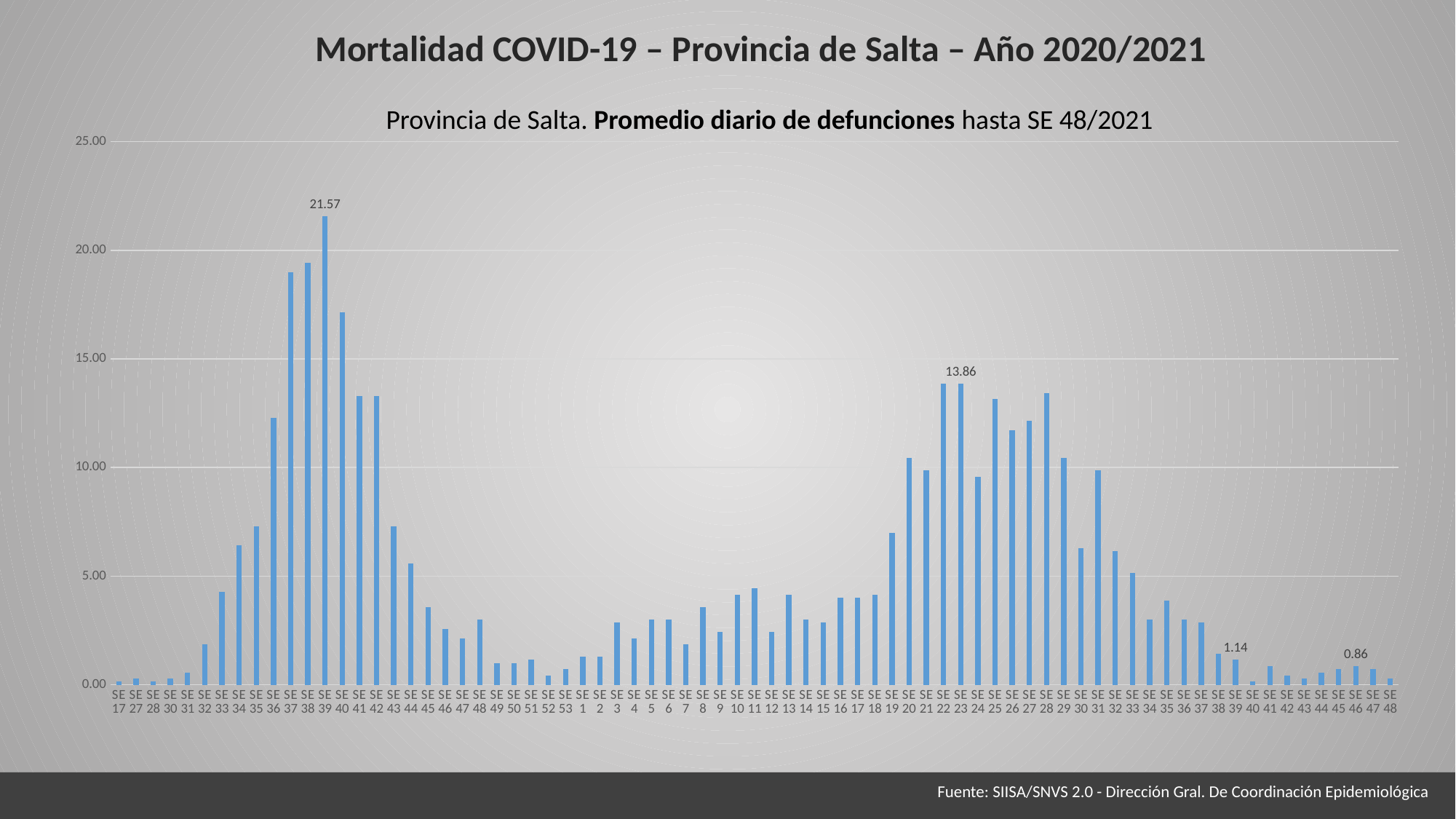
What is the source cited at the bottom of the slide? SIISA/SNVS 2.0 - Dirección Gral. De Coordinación Epidemiológica Which week has the highest daily average of deaths? SE 39 (2020) What is the value printed above the bar for SE 46 in the 2021 section? 0.86 Do the values rise or fall from SE 39 to SE 49 in the 2020 section? fall What is the value printed above the bar for SE 23 in the 2021 section? 13.86 Is the value for SE 37 in the 2020 section greater or less than 15.00? greater What is the value of the tallest bar, at the first SE 39 (2020 section)? 21.57 What is the value printed above the bar for the second SE 39 (2021 section)? 1.14 Which is larger, the value for SE 39 in 2020 (21.57) or the value for SE 23 in 2021 (13.86)? SE 39 in 2020 (21.57) What is the difference between the peak value 21.57 and the second peak value 13.86? 7.71 What kind of chart is shown on the slide? bar chart Is the value for SE 49 in the 2020 section greater or less than 5.00? less